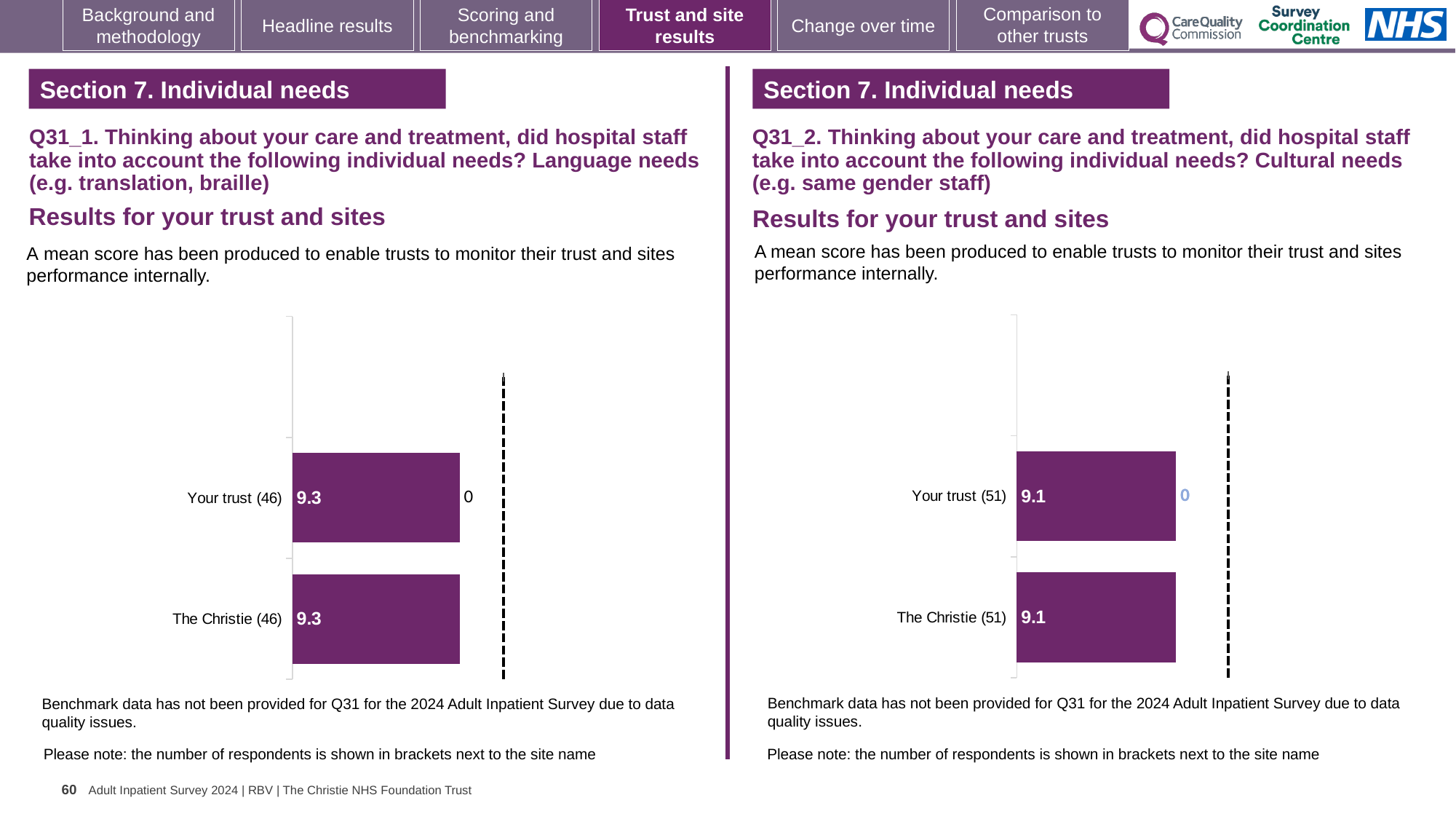
On the right chart (Q31_2, Cultural needs), what is the mean score for The Christie? 9.1 On the right chart (Q31_2, Cultural needs), what is the difference between the scores for Your trust and The Christie? 0 On the left chart (Q31_1, Language needs), how many respondents are shown in brackets next to Your trust? 46 Is the score for Your trust on the right chart (Q31_2, Cultural needs) higher or lower than the score for Your trust on the left chart (Q31_1, Language needs)? Lower On the left chart (Q31_1, Language needs), what is the mean score for Your trust? 9.3 On the right chart (Q31_2, Cultural needs), how many respondents are shown in brackets next to The Christie? 51 What type of chart is used on the left side of the slide (Q31_1, Language needs)? Bar chart On the left chart (Q31_1, Language needs), what is the mean score for The Christie? 9.3 How many bars are plotted on the left chart (Q31_1, Language needs)? 2 How many bars are plotted on the right chart (Q31_2, Cultural needs)? 2 On the right chart (Q31_2, Cultural needs), what is the mean score for Your trust? 9.1 On the left chart (Q31_1, Language needs), what is the difference between the scores for Your trust and The Christie? 0